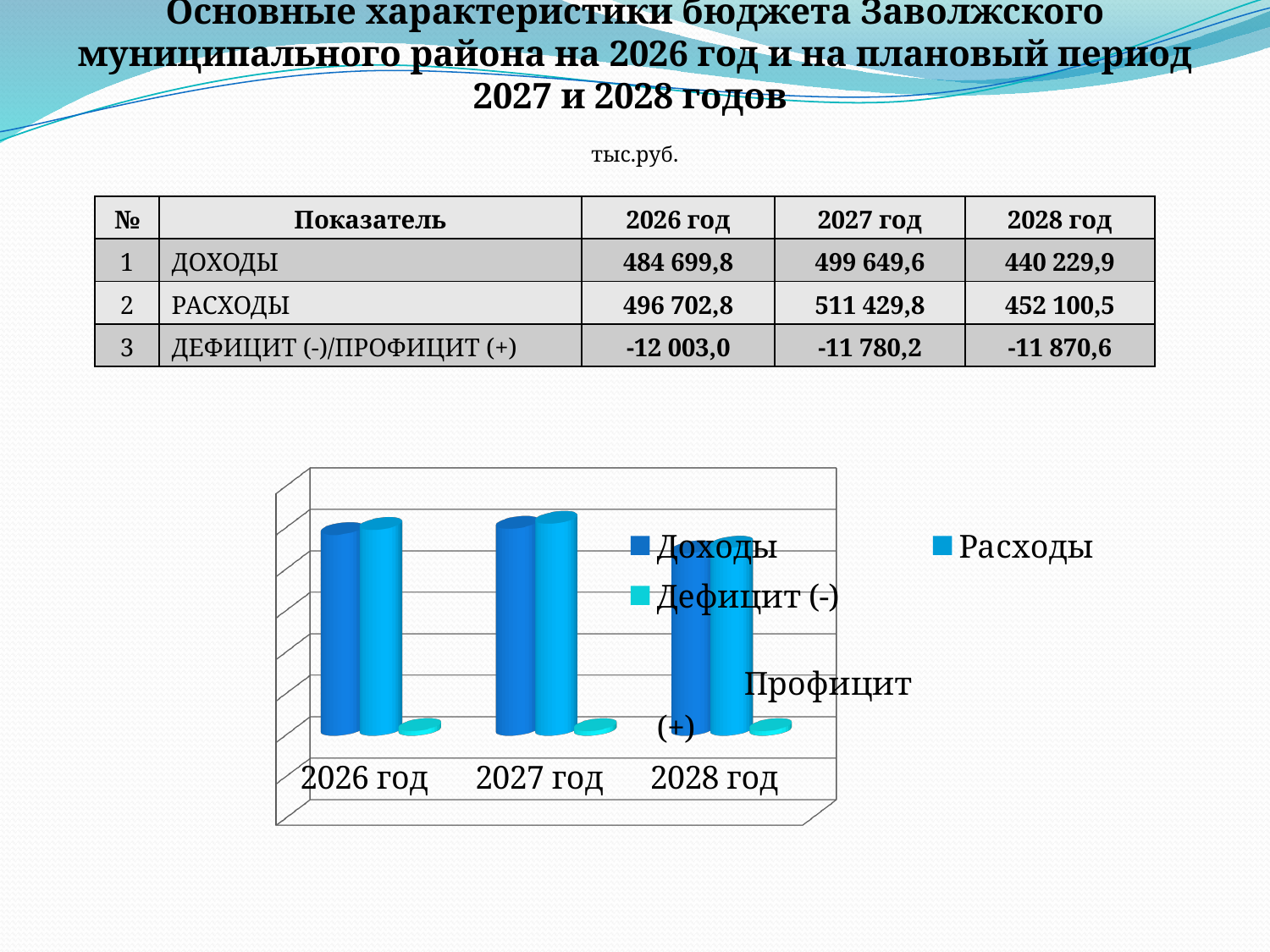
What is the difference between Расходы and Доходы for 2027 год? 11 780,2 What is the value of Расходы for 2027 год? 511 429,8 How many series does the chart legend list? 3 Do the Доходы bars rise or fall from 2027 год to 2028 год? fall How many year categories are shown on the x axis of the chart? 3 For 2026 год, which is larger: Доходы or Расходы? Расходы In which year is the Доходы bar the shortest? 2028 год In which year is the Расходы bar the tallest? 2027 год Which series is shown in the darkest blue in the chart legend? Доходы What is the value of Дефицит (-)/Профицит (+) for 2028 год? -11 870,6 What is the value of Доходы for 2026 год? 484 699,8 What kind of chart is shown on the slide? bar chart